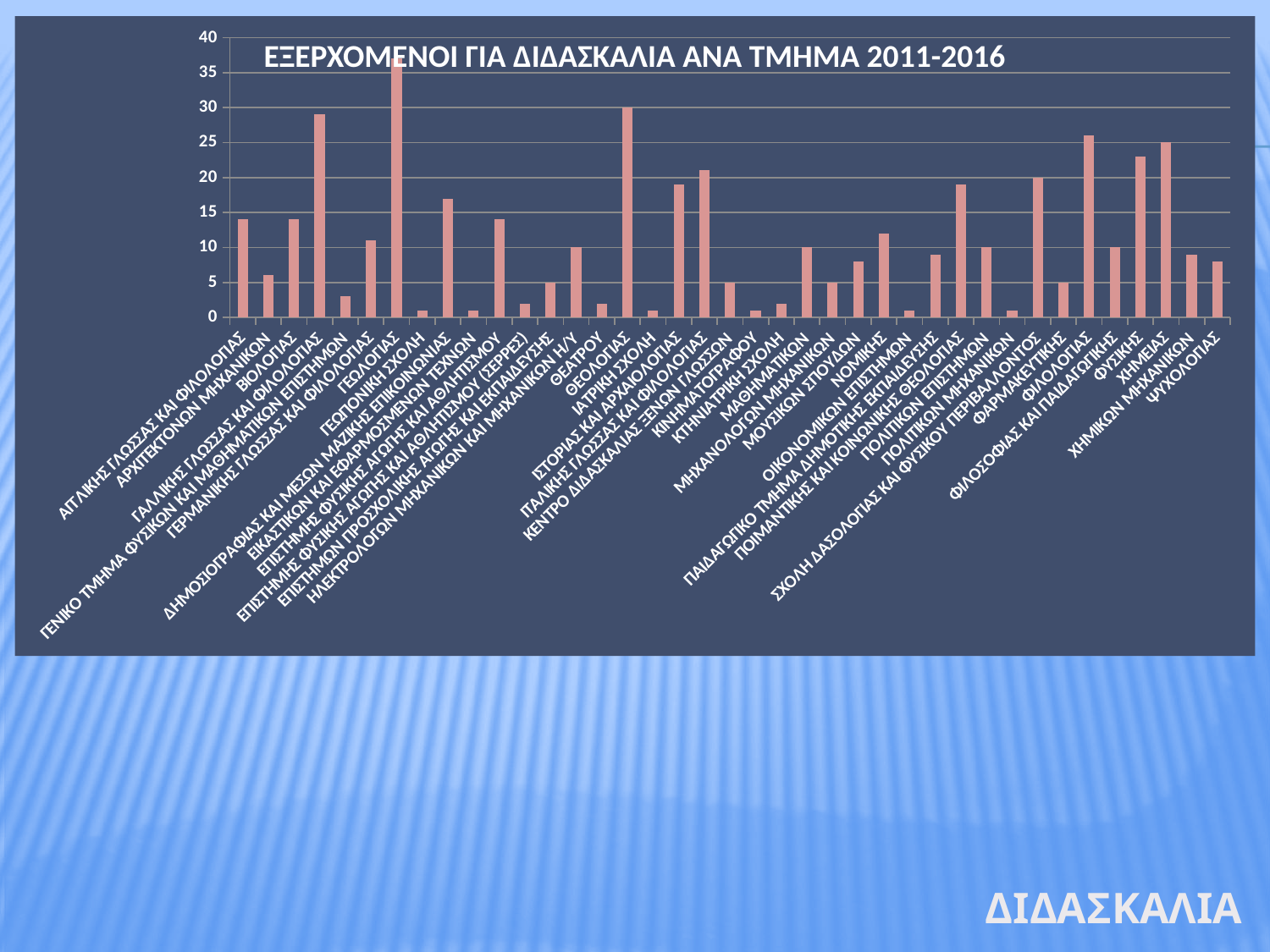
Which department has the highest bar in the chart? ΓΕΩΛΟΓΙΑΣ Which is larger, the value for ΦΙΛΟΛΟΓΙΑΣ or the value for ΦΥΣΙΚΗΣ? ΦΙΛΟΛΟΓΙΑΣ What is the title of the chart? ΕΞΕΡΧΟΜΕΝΟΙ ΓΙΑ ΔΙΔΑΣΚΑΛΙΑ ΑΝΑ ΤΜΗΜΑ 2011-2016 What is the value for ΣΧΟΛΗ ΔΑΣΟΛΟΓΙΑΣ ΚΑΙ ΦΥΣΙΚΟΥ ΠΕΡΙΒΑΛΛΟΝΤΟΣ? 20 What is the value for ΧΗΜΕΙΑΣ? 25 Is the value for ΓΕΩΛΟΓΙΑΣ greater or less than 35? greater Is the value for ΑΡΧΙΤΕΚΤΟΝΩΝ ΜΗΧΑΝΙΚΩΝ greater or less than 10? less What is the maximum value shown on the vertical axis? 40 Which is larger, the value for ΝΟΜΙΚΗΣ or the value for ΘΕΟΛΟΓΙΑΣ? ΘΕΟΛΟΓΙΑΣ What is the value for ΘΕΟΛΟΓΙΑΣ? 30 What type of chart is shown on the slide? bar chart Is the value for ΓΑΛΛΙΚΗΣ ΓΛΩΣΣΑΣ ΚΑΙ ΦΙΛΟΛΟΓΙΑΣ greater or less than 25? greater